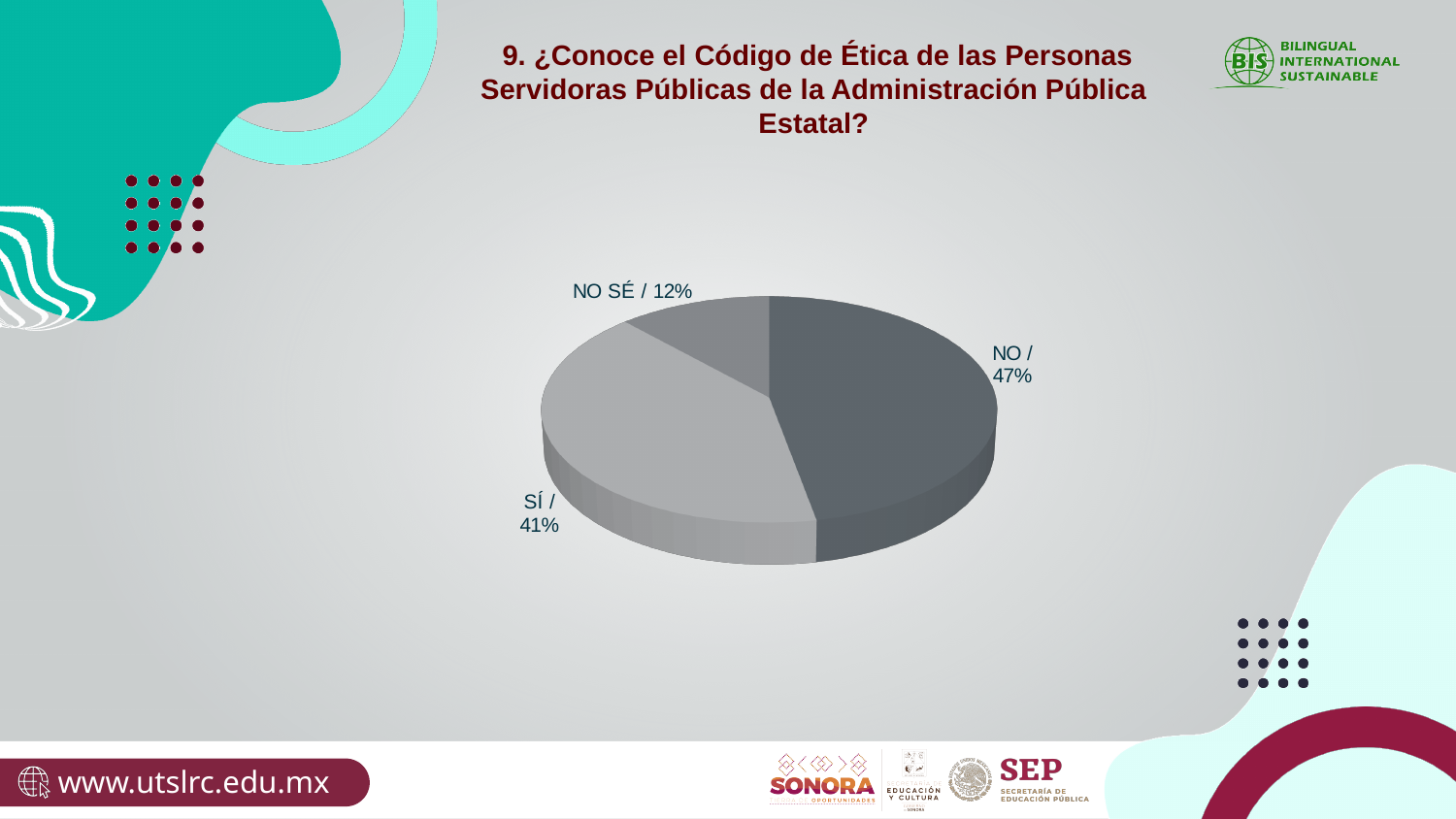
What percentage of respondents answered NO SÉ? 12% What is the difference in percentage points between the NO and SÍ slices? 6 Which response has the largest share of the pie? NO What percentage of respondents answered NO? 47% What percentage of respondents answered SÍ? 41% How many slices does the pie chart have? 3 What is the difference in percentage points between the SÍ and NO SÉ slices? 29 What question number is shown in the chart title? 9 Which is larger, the share for SÍ or the share for NO SÉ? SÍ What kind of chart is shown on the slide? pie chart Which response has the smallest share of the pie? NO SÉ What is the combined share of the SÍ and NO slices? 88%